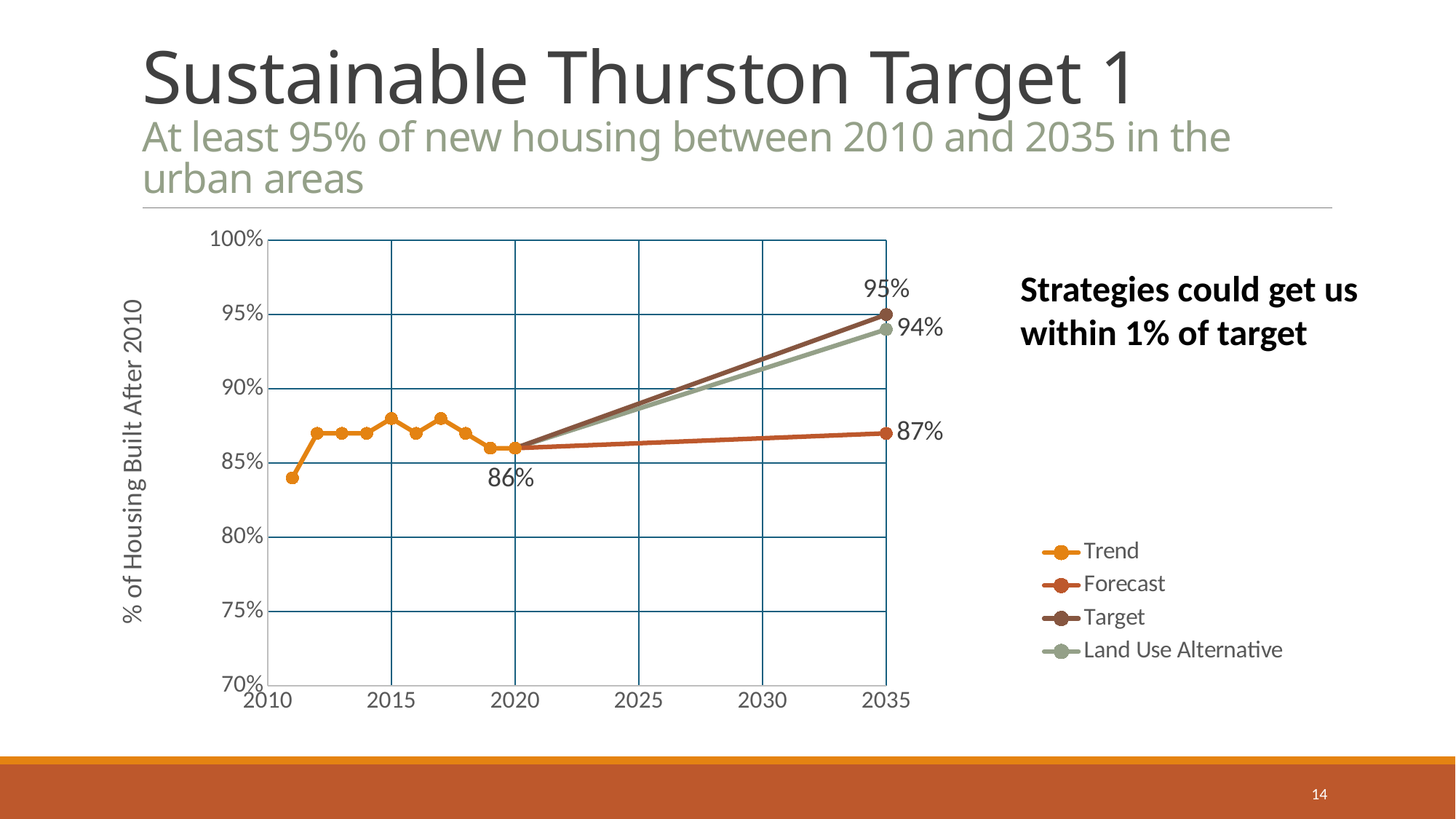
What is the difference between the Target value and the Land Use Alternative value in 2035? 1% Does the Target line rise or fall between 2020 and 2035? rise What is the difference between the Target value and the Forecast value in 2035? 8% What value does the Forecast series reach in 2035? 87% What kind of chart is shown on the slide? line chart What is the title of the vertical axis? % of Housing Built After 2010 What is the labelled value in 2020 where the Trend line ends and the projections begin? 86% What value does the Land Use Alternative series reach in 2035? 94% Is the Trend value for 2011 greater or less than 85%? less In 2035, which is higher: the Target series or the Forecast series? Target How many series does the chart legend list? 4 What value does the Target series reach in 2035? 95%